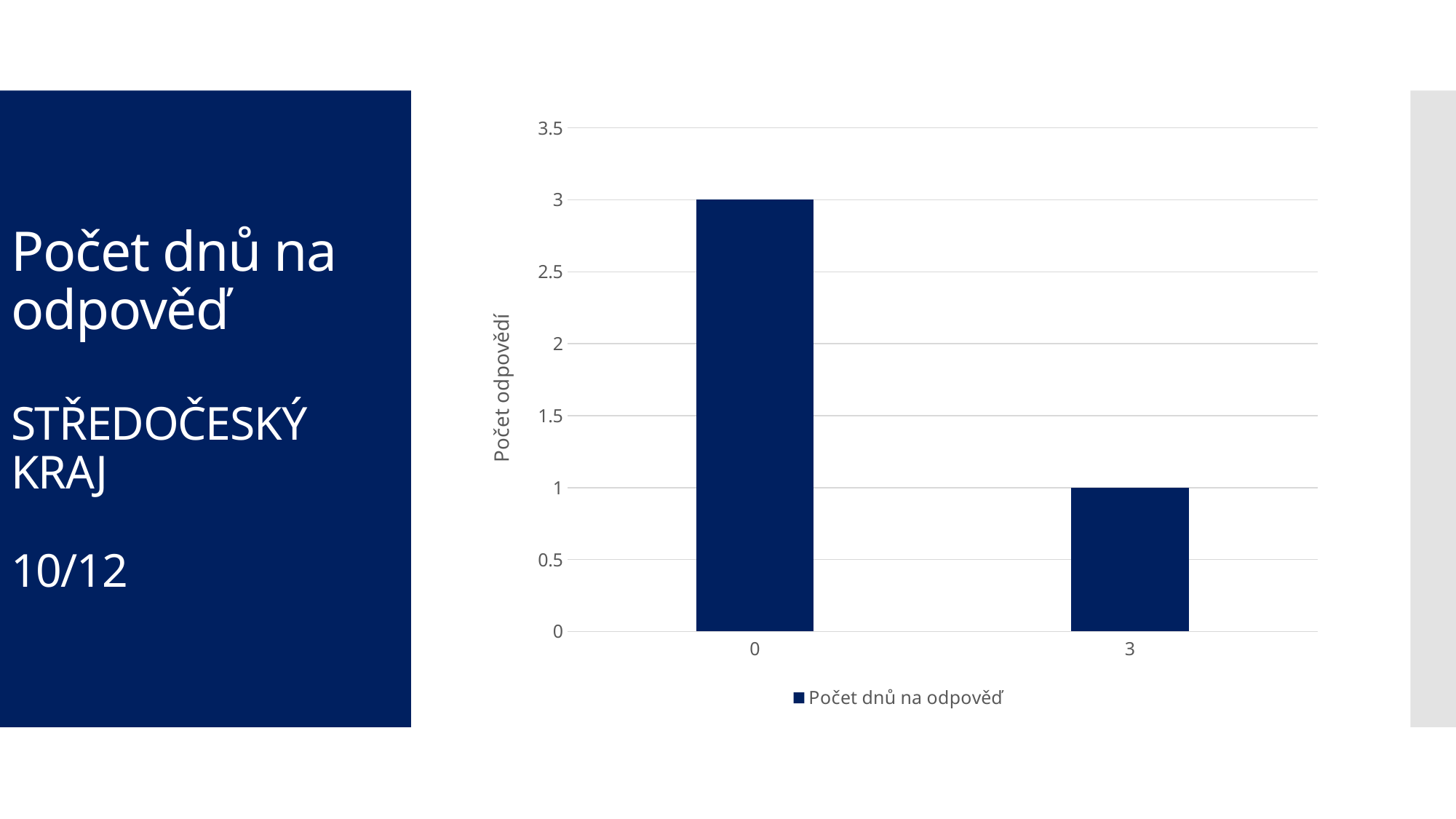
What is the difference between the values for category 0 and category 3? 2 How many series does the chart legend list? 1 What is the value for category 0 in the chart? 3 What is the value for category 3 in the chart? 1 Which category has the lowest value in the chart? 3 How many categories are shown on the x axis of the chart? 2 What is the label of the y axis of the chart? Počet odpovědí What kind of chart is shown on the slide? bar chart Which is larger, the value for category 0 or the value for category 3? 0 Is the value for category 0 greater or less than 2? greater Do the values rise or fall from left to right along the x axis? fall Which category has the highest value in the chart? 0